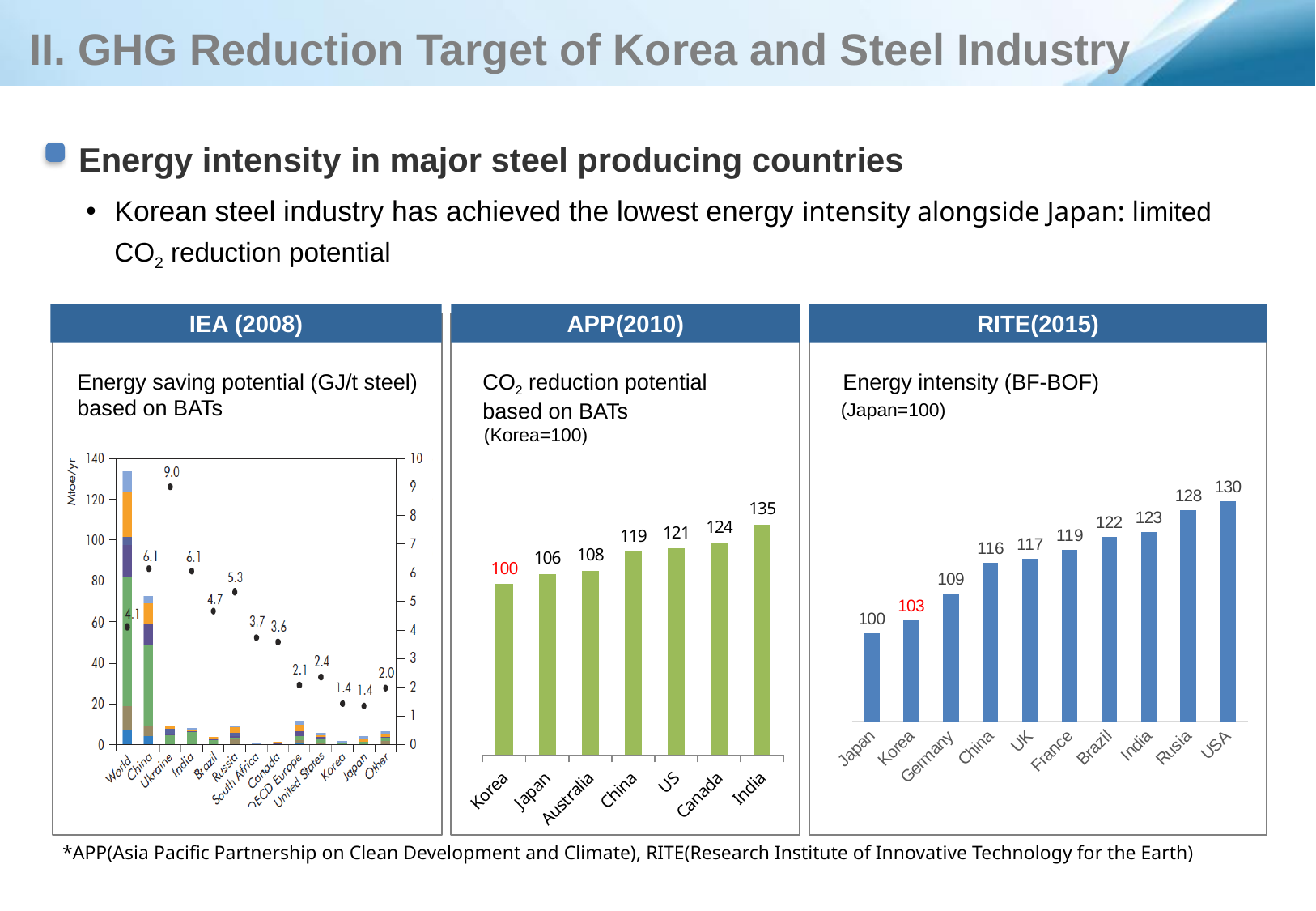
In the APP(2010) chart, which country has the lowest value? Korea In the RITE(2015) chart, what is the value for Korea? 103 In the RITE(2015) chart, which is larger, the value for France or the value for Germany? France In the RITE(2015) chart, which country has the highest value? USA In the APP(2010) chart, what is the value for Australia? 108 In the IEA (2008) chart, which country has the highest dot value (GJ/t steel)? Ukraine In the APP(2010) chart, what is the value for India? 135 How many countries are shown in the RITE(2015) chart? 10 In the RITE(2015) chart, do the values rise or fall from left to right? rise In the APP(2010) chart, what is the difference between the values for India and Korea? 35 In the RITE(2015) chart, what is the difference between the values for USA and Japan? 30 How many countries are shown in the APP(2010) chart? 7